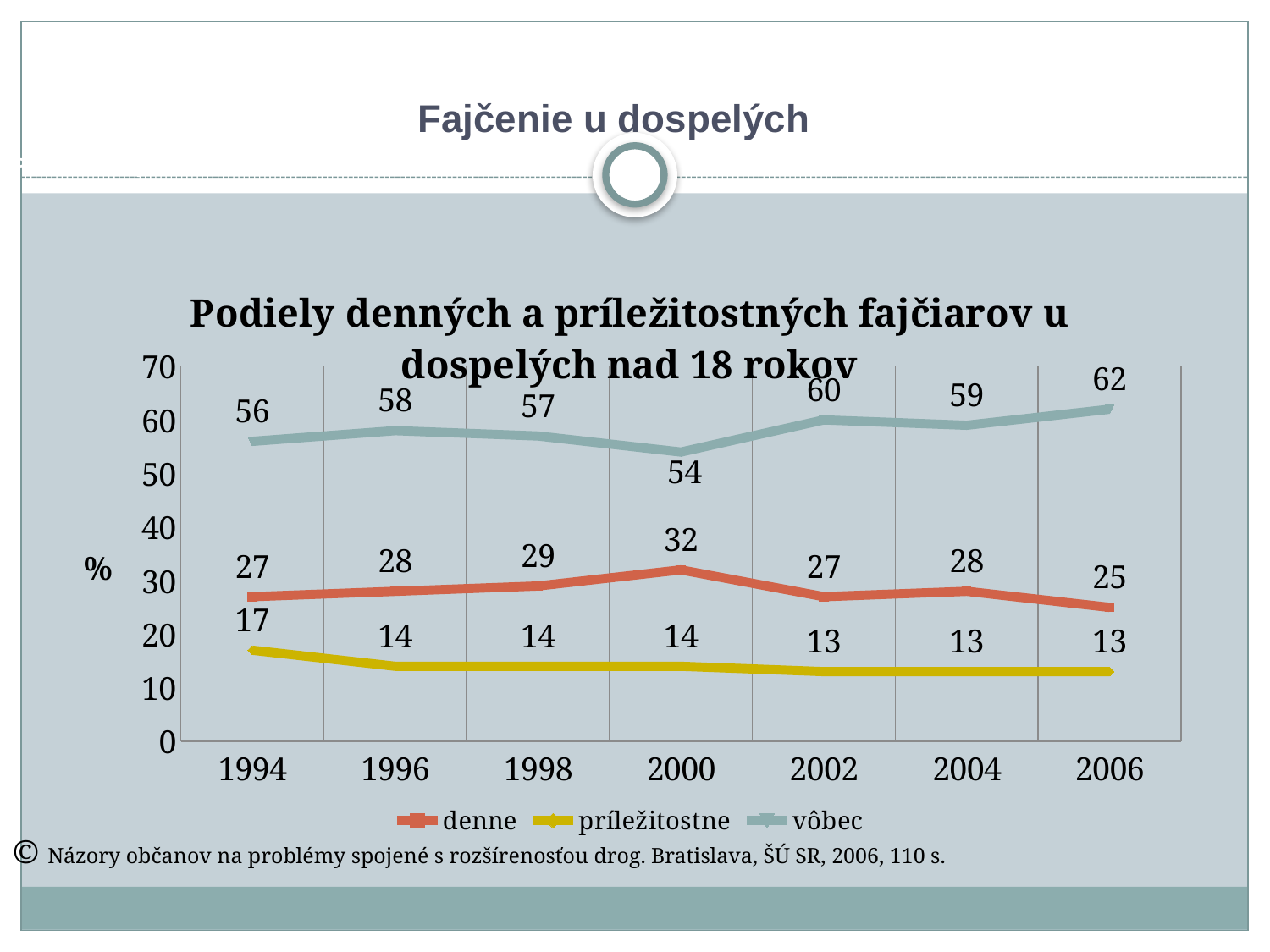
How many years are plotted on the x axis? 7 What is the value for 'vôbec' in 2006? 62 What is the value for 'denne' in 2000? 32 What type of chart is shown on the slide? line chart Does the 'príležitostne' series rise or fall from 1994 to 2006? fall In which year is the 'denne' series highest? 2000 In which year is the 'vôbec' series lowest? 2000 How many series does the legend list? 3 What is the value for 'príležitostne' in 1994? 17 What is the difference between the 'vôbec' value and the 'denne' value in 2006? 37 What is the title of the chart? Podiely denných a príležitostných fajčiarov u dospelých nad 18 rokov Which is larger in 2002: the 'denne' value or the 'príležitostne' value? denne